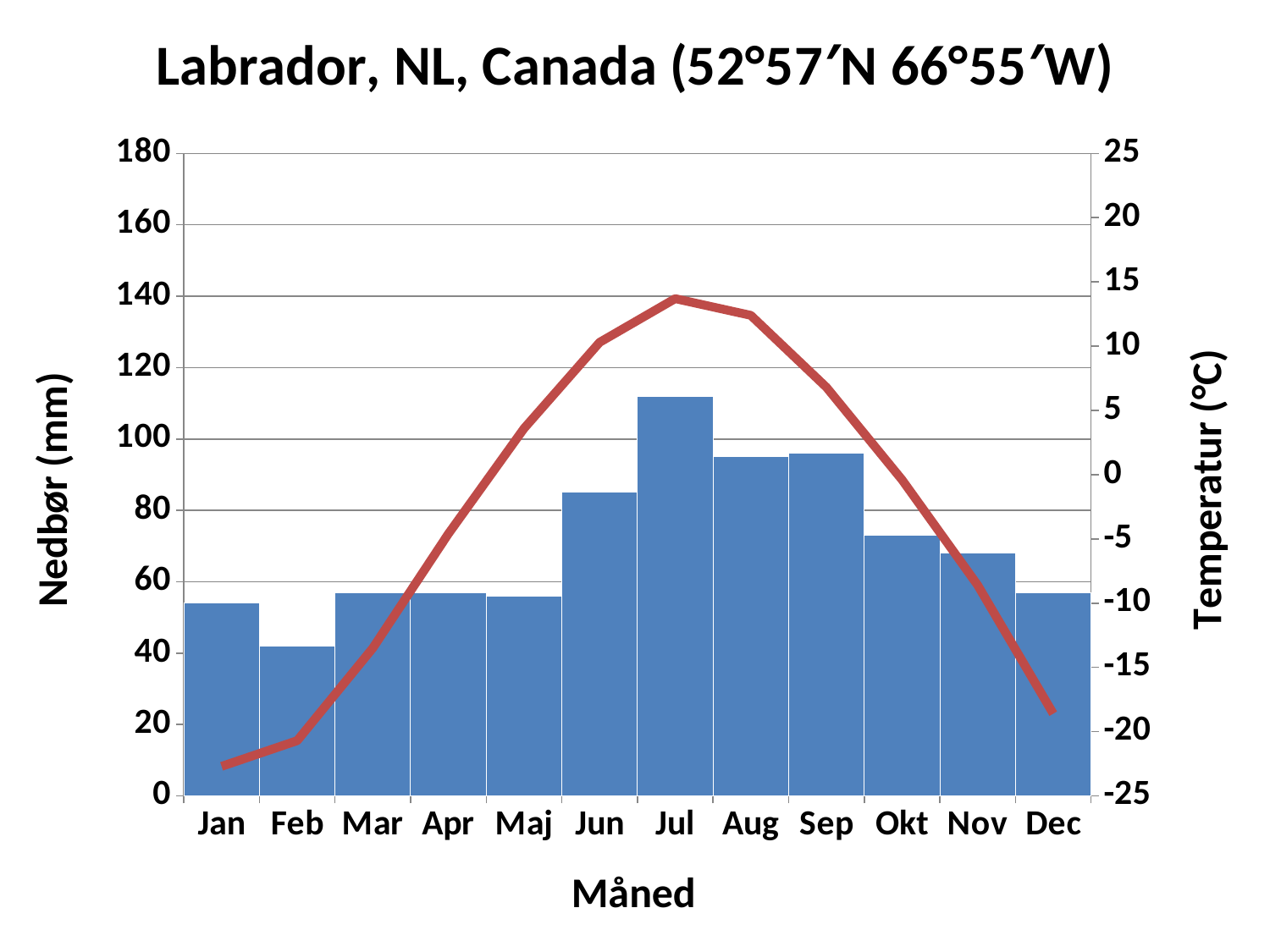
Which month has the highest precipitation (Nedbør) bar? Jul Which month has the lowest precipitation (Nedbør) bar? Feb In which month does the temperature line reach its highest point? Jul Does the temperature line rise or fall from Jul to Dec? Fall Is the temperature for Jan greater or less than -20 °C? less Is the temperature for Jul greater or less than 10 °C? greater How many months are shown on the x axis? 12 Is the precipitation value for Feb greater or less than 60 mm? less Which month has the larger precipitation bar, Jan or Feb? Jan What kind of chart is this? A combined bar and line chart In which month does the temperature line reach its lowest point? Jan